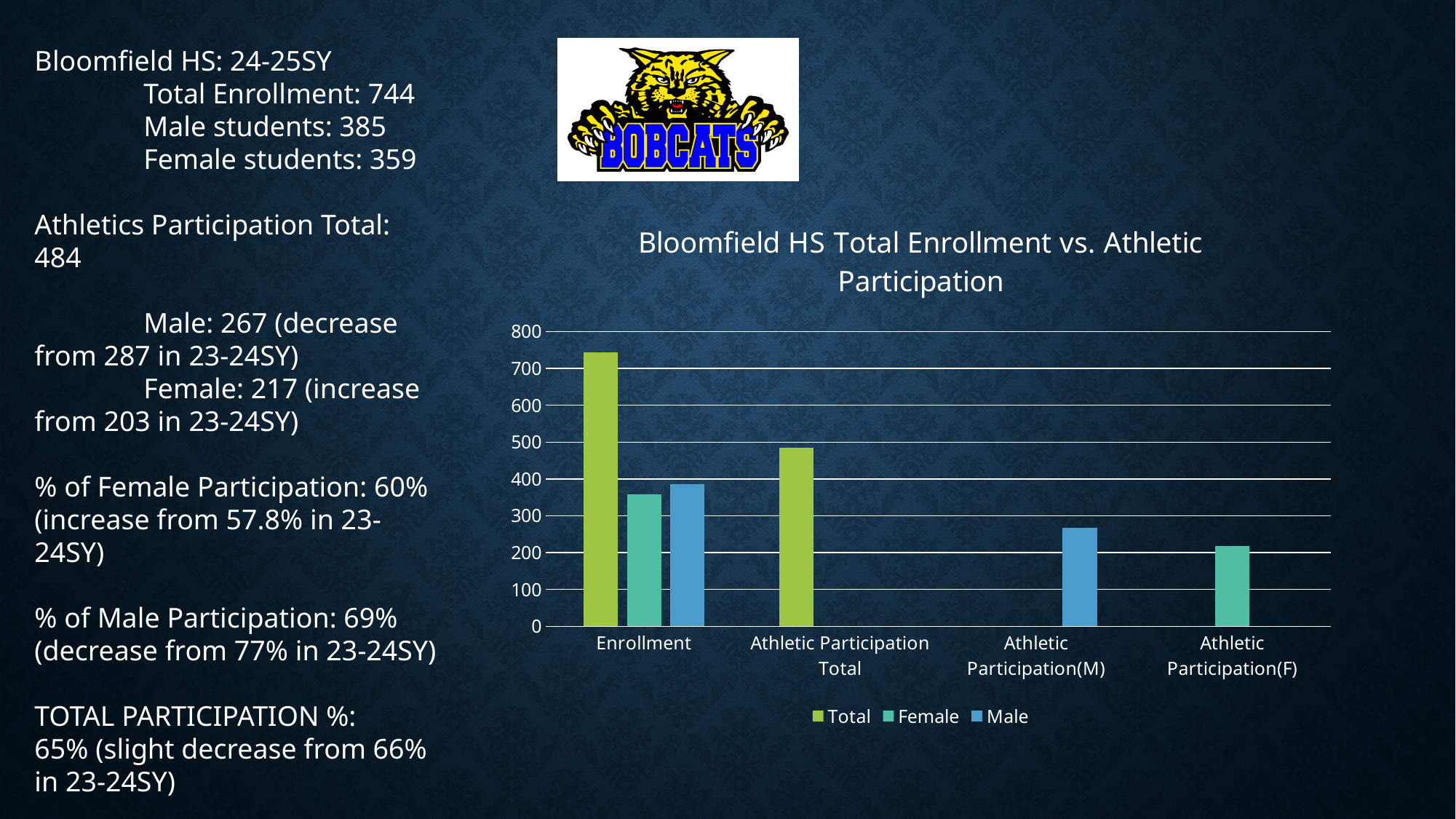
Is the Male value for Athletic Participation(M) greater or less than 300? less Is the Female value for Enrollment greater or less than 400? less Is the Total value for Enrollment greater or less than 700? greater What kind of chart is shown on the slide? bar chart Which category has the highest Total bar? Enrollment In the Enrollment category, which is larger, the Male bar or the Female bar? Male How many series does the chart legend list? 3 What is the title of the chart? Bloomfield HS Total Enrollment vs. Athletic Participation How many categories are shown on the x axis of the chart? 4 Which series is shown in green in the chart legend? Total